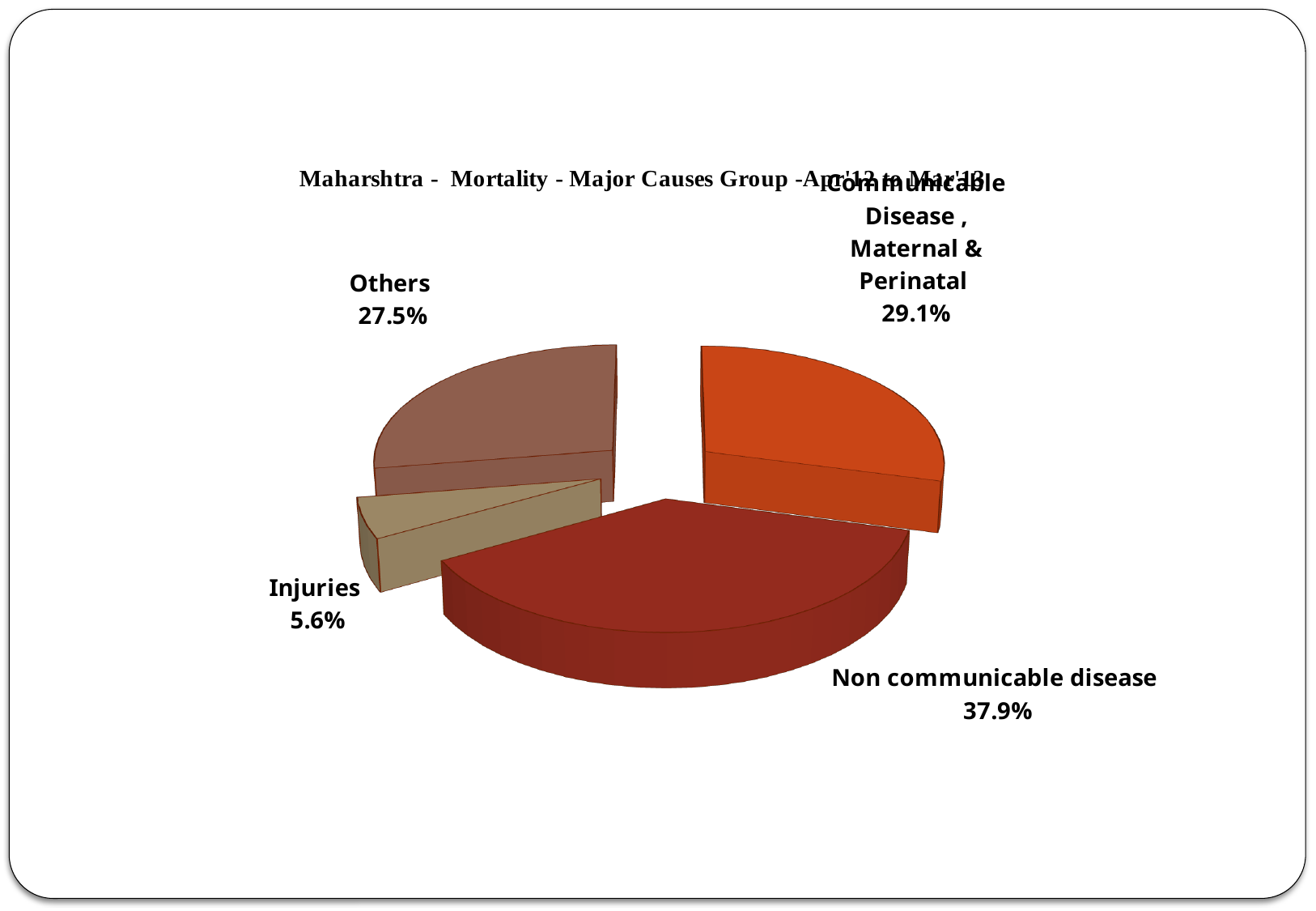
How many slices does the pie chart have? 4 Which cause group has the largest share of the pie? Non communicable disease What percentage of mortality is attributed to Non communicable disease? 37.9% Which cause group has the smallest share of the pie? Injuries What percentage of mortality is attributed to Communicable Disease, Maternal & Perinatal? 29.1% What kind of chart is shown on the slide? Pie chart What is the difference in percentage points between Others and Injuries? 21.9 Which is larger: the share for Others or the share for Communicable Disease, Maternal & Perinatal? Communicable Disease, Maternal & Perinatal What is the difference in percentage points between Non communicable disease and Communicable Disease, Maternal & Perinatal? 8.8 Which state is named in the chart title? Maharshtra What percentage of mortality is attributed to Injuries? 5.6% What percentage of mortality is attributed to Others? 27.5%